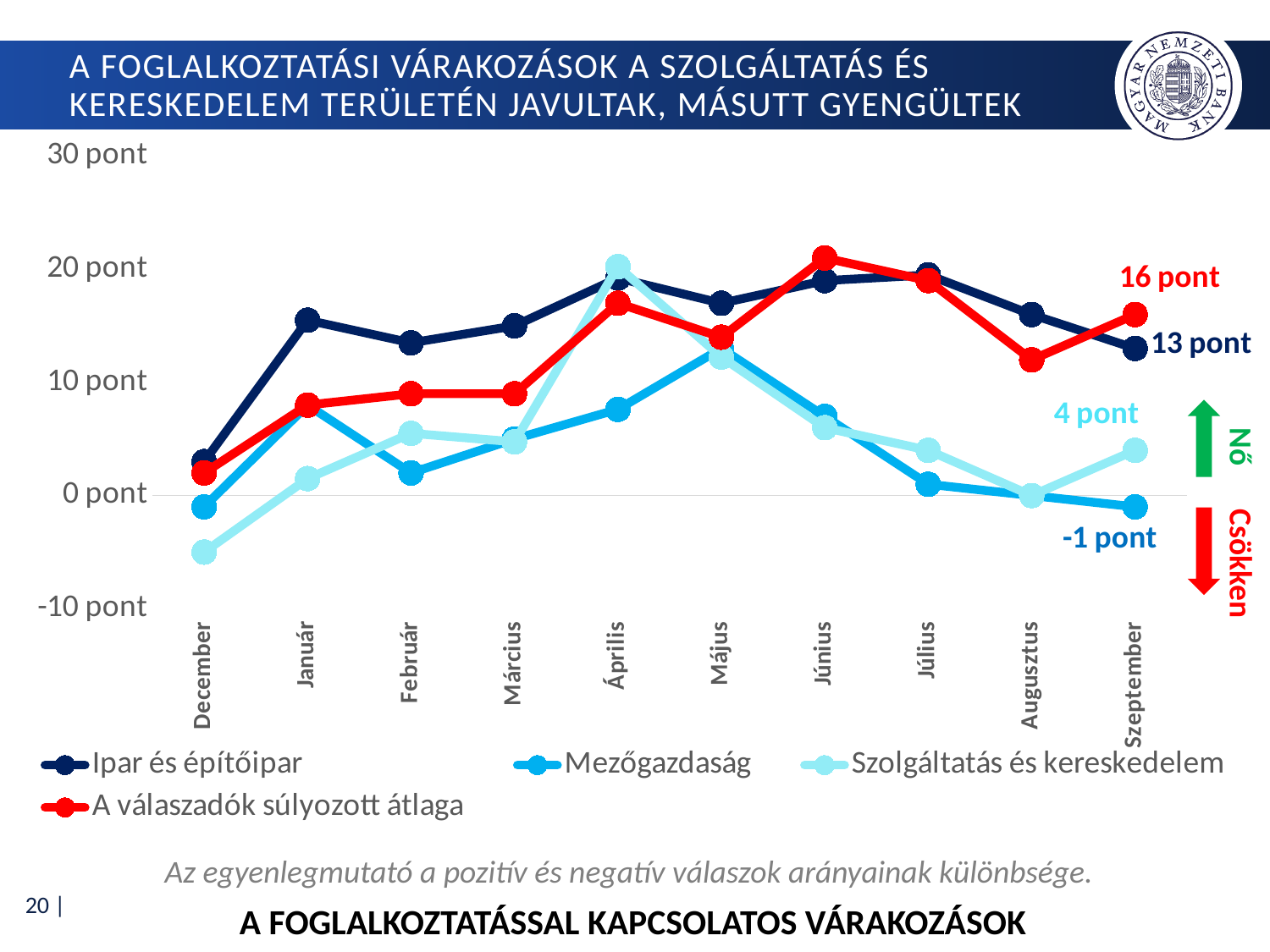
What is the value of 'Szolgáltatás és kereskedelem' in Szeptember? 4 pont Is the value for 'Szolgáltatás és kereskedelem' in December greater or less than 0 pont? less What is the value of 'Ipar és építőipar' in Szeptember? 13 pont Which series has the lowest value in Szeptember? Mezőgazdaság What is the value of 'A válaszadók súlyozott átlaga' in Szeptember? 16 pont Which series has the highest value in Szeptember? A válaszadók súlyozott átlaga Is the value for 'Ipar és építőipar' in Január greater or less than 10 pont? greater What is the difference between 'A válaszadók súlyozott átlaga' and 'Ipar és építőipar' in Szeptember? 3 pont What is the value of 'Mezőgazdaság' in Szeptember? -1 pont How many months are shown along the x axis? 10 What kind of chart is shown on the slide? line chart How many series does the legend list? 4